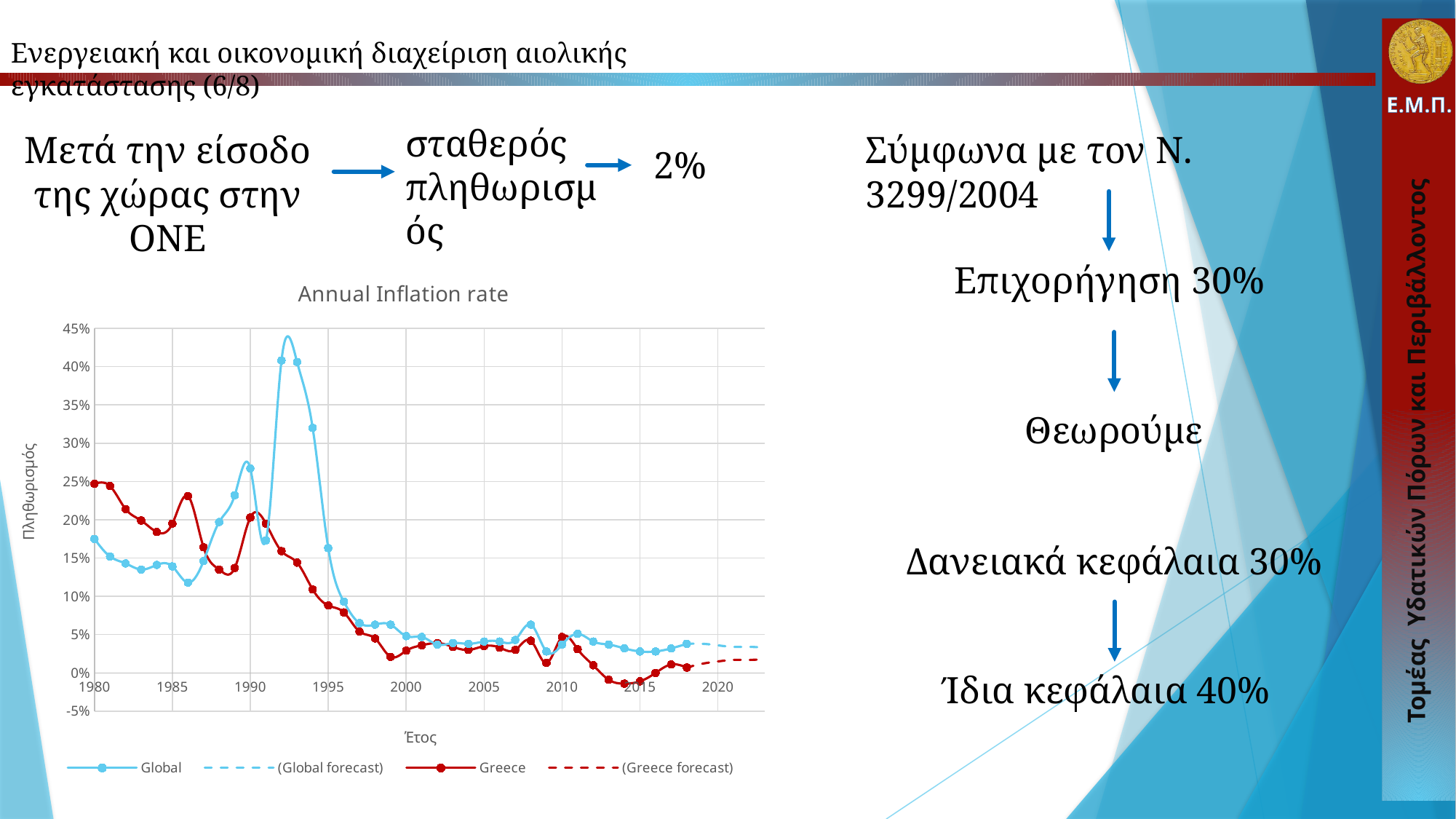
How many series does the chart legend list? 4 Is the Global inflation value for 1992 greater or less than 35%? greater In 1980, which series has the higher inflation value, Global or Greece? Greece In 1992, which series has the higher inflation value, Global or Greece? Global Does the Greece inflation series overall rise or fall between 1980 and 2015? Fall Is the Global inflation value for 1986 greater or less than 15%? less Is the Greece inflation value for 1980 greater or less than 20%? greater What is the label of the x axis of the chart? Έτος Which series reaches the highest peak on the chart, Global or Greece? Global What kind of chart is shown on the slide? Line chart What is the title of the chart? Annual Inflation rate